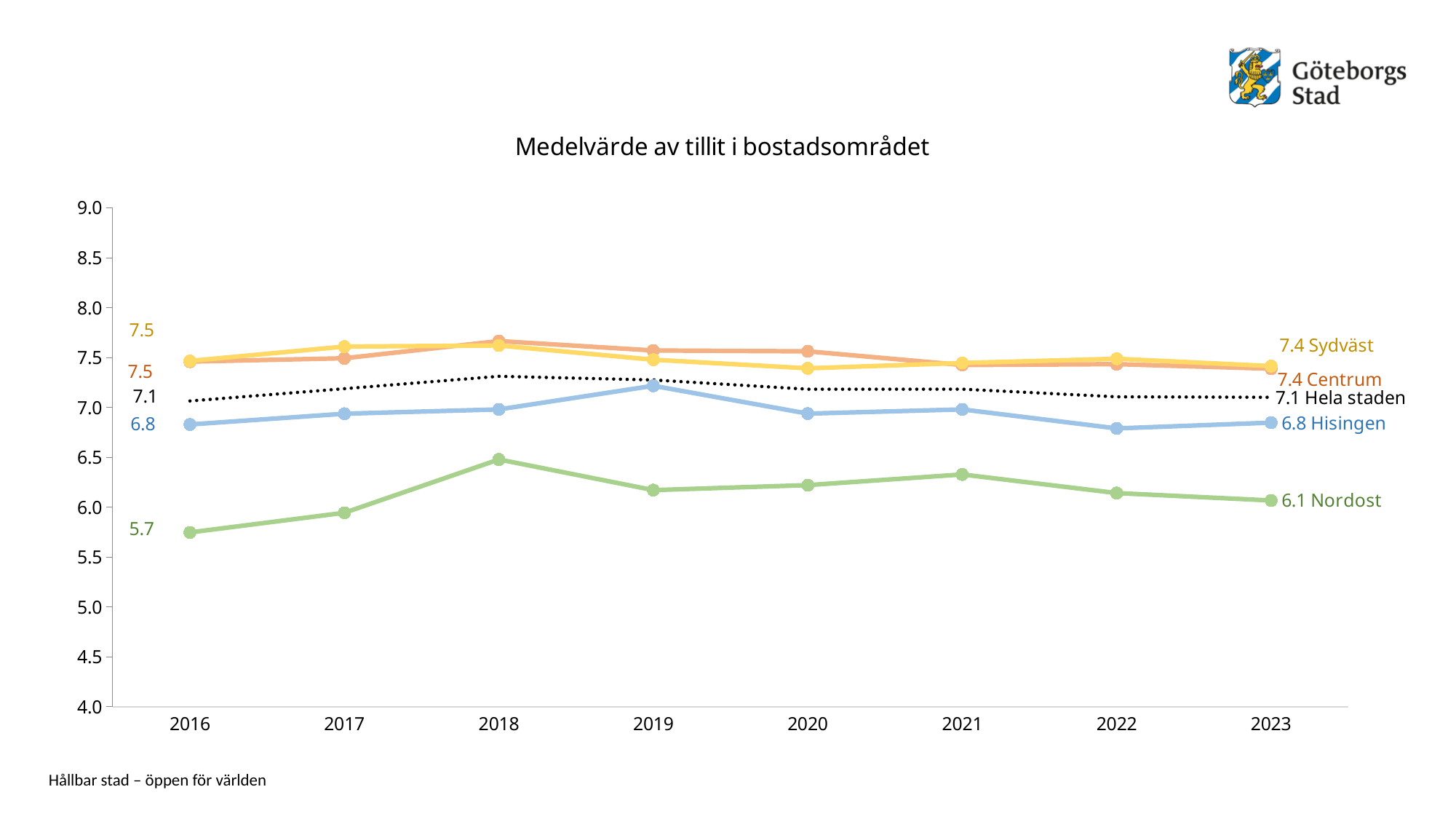
What kind of chart is shown on the slide? line chart Which series has the lowest value in 2023? Nordost What is the title of the chart? Medelvärde av tillit i bostadsområdet What is the value for Nordost in 2016? 5.7 What is the value for Hela staden in 2016? 7.1 Is the value for Hisingen in 2019 greater or less than 7.0? greater Which is larger in 2016, the value for Hisingen or the value for Nordost? Hisingen By how much did the value for Nordost change from 2016 to 2023? 0.4 What is the value for Hisingen in 2023? 6.8 How many years are shown on the x axis of the chart? 8 How many series (areas) are plotted in the chart? 5 What is the value for Nordost in 2023? 6.1